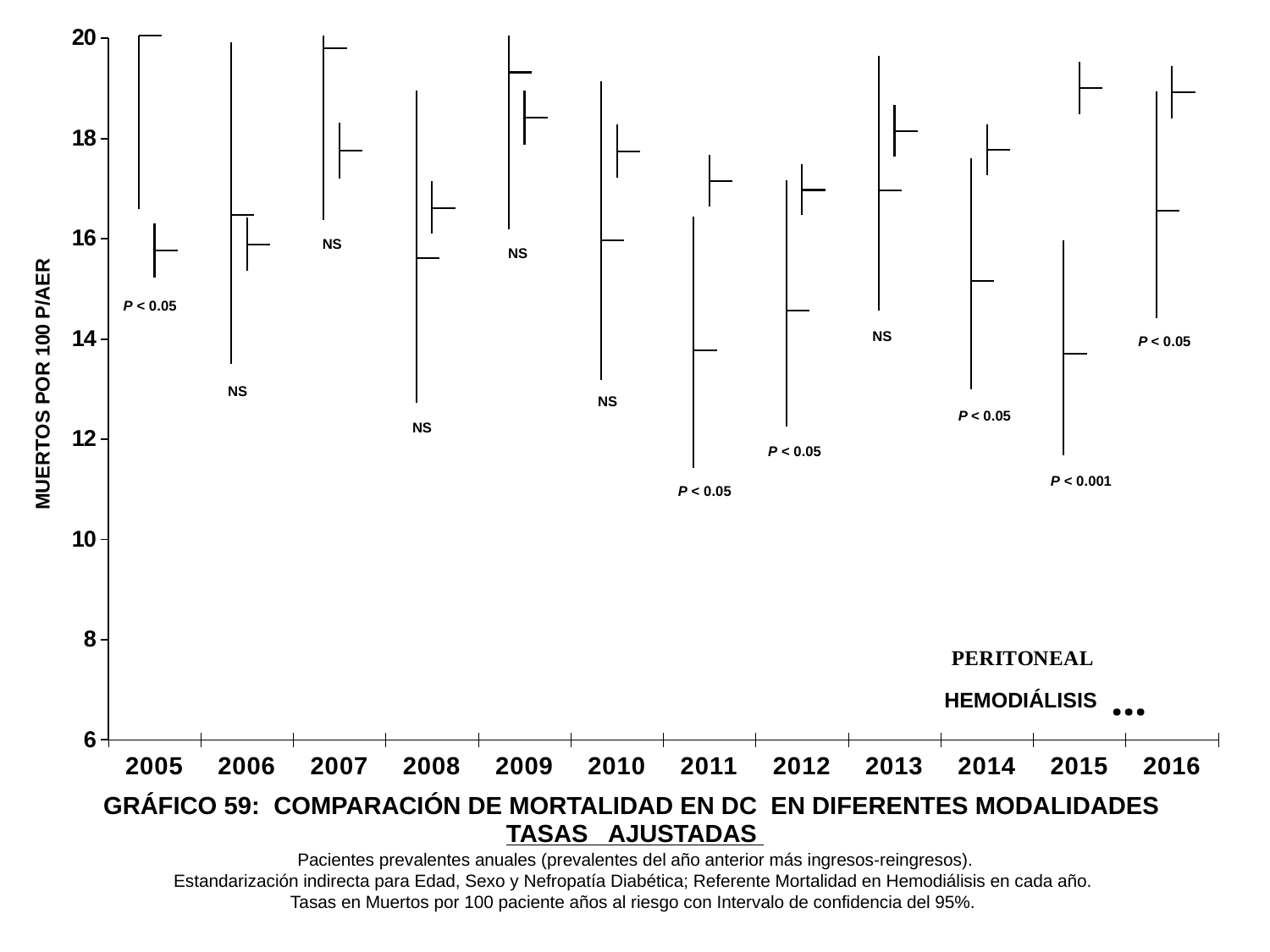
How many years are shown on the x axis of the chart? 12 What significance annotation is printed for 2015? P < 0.001 Is the midpoint of the right interval for 2015 greater or less than 18? greater What are the two modalities named in the legend? PERITONEAL and HEMODIÁLISIS Is the midpoint of the left interval for 2015 greater or less than 16? less Which year is the only one annotated with P < 0.001? 2015 What significance annotation is printed for 2013? NS What significance annotation is printed for 2016? P < 0.05 How many modalities does the legend list? 2 What is the label of the y axis? MUERTOS POR 100 P/AER What significance annotation is printed for 2005? P < 0.05 How many years are annotated with NS? 6